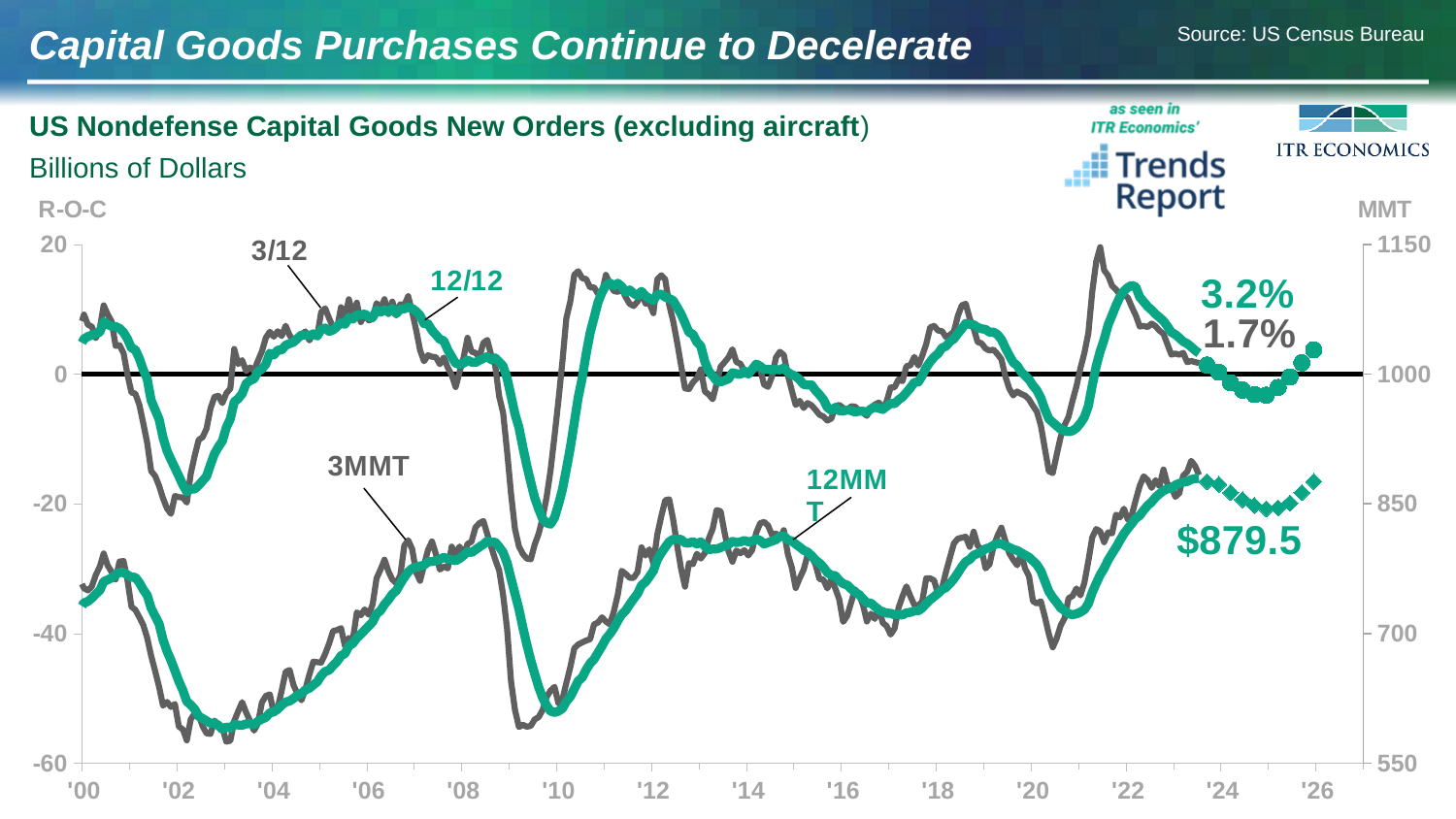
How many data series are labeled on the chart? 4 Is the 3/12 series' lowest point around 2009 greater or less than -20 on the R-O-C axis? less What is the latest labeled value of the 12MMT series? $879.5 Which is larger, the latest labeled 12/12 value or the latest labeled 3/12 value? 12/12 (3.2%) What is the difference between the latest labeled 12/12 value (3.2%) and the latest labeled 3/12 value (1.7%)? 1.5 percentage points Does the 12MMT series rise or fall between 2020 and 2022? rise What is the source cited for the chart data? US Census Bureau What is the latest labeled value of the 12/12 rate-of-change series? 3.2% What is the latest labeled value of the 3/12 rate-of-change series? 1.7% Is the 12MMT series' lowest point around 2009-2010 greater or less than 700 on the MMT axis? less What kind of chart is shown on the slide? line chart What is the title of the chart? US Nondefense Capital Goods New Orders (excluding aircraft)